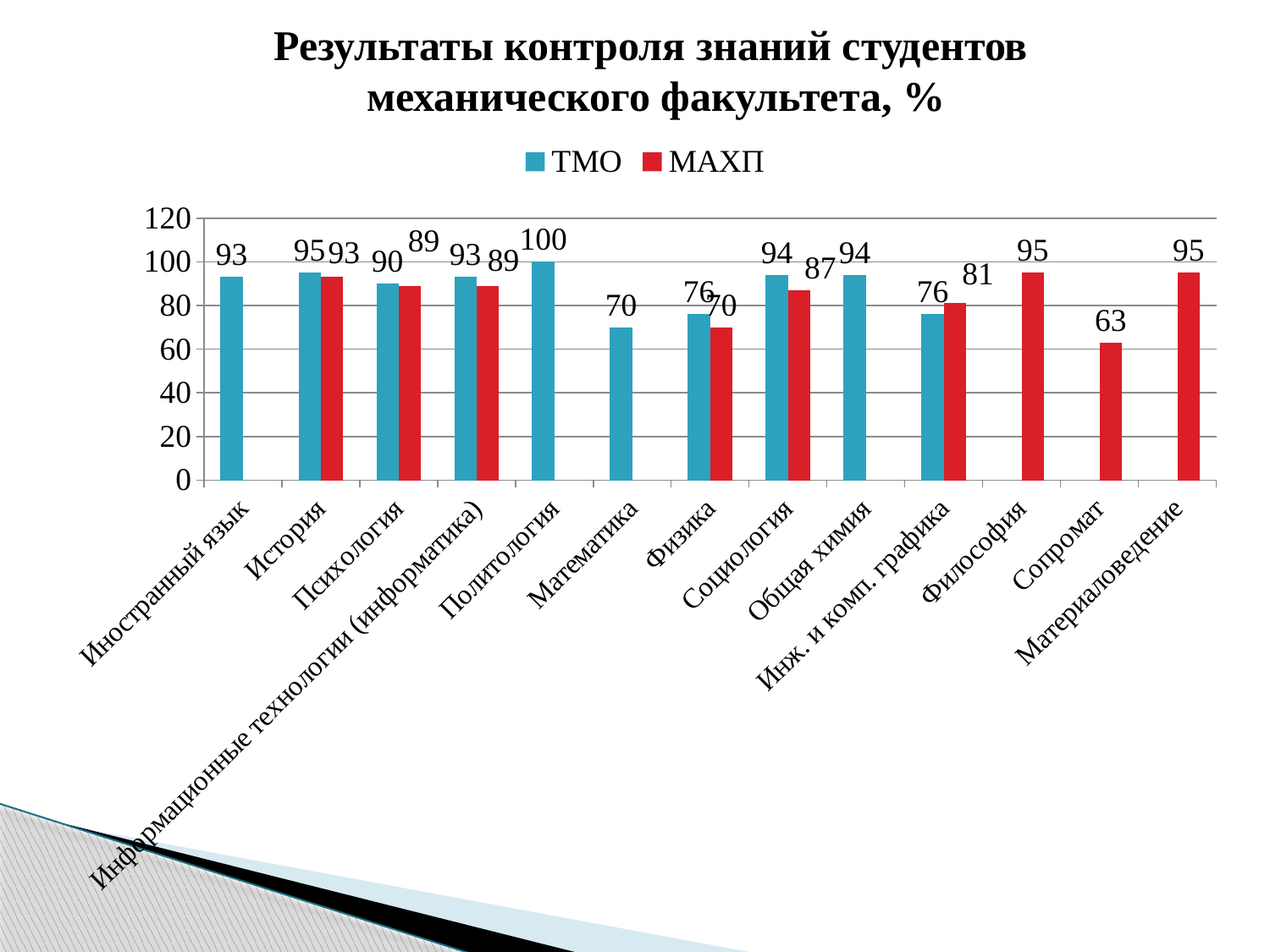
What is the МАХП value for Сопромат? 63 How many categories are shown on the x axis? 13 For Инж. и комп. графика, which series has the larger value, ТМО or МАХП? МАХП Which category has the highest ТМО value? Политология What is the difference between the ТМО and МАХП values for Социология? 7 What kind of chart is shown on the slide? bar chart What is the ТМО value for Социология? 94 What is the ТМО value for Политология? 100 How many series does the legend list? 2 Is the ТМО value for Математика greater or less than 80? less Which category has the lowest МАХП value? Сопромат What is the МАХП value for Инж. и комп. графика? 81